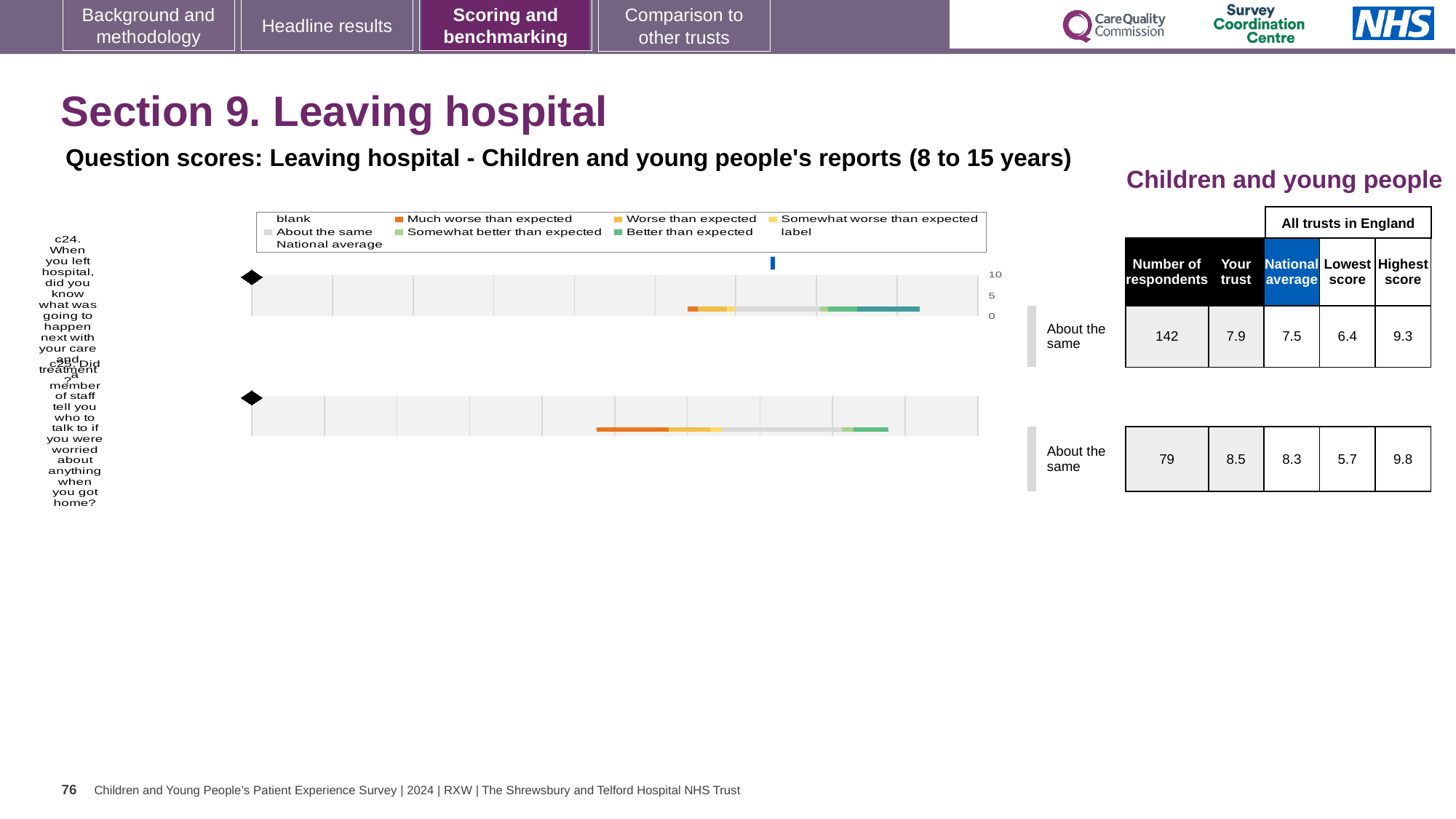
What is the highest score among all trusts in England for question c24? 9.3 By how much does the trust's score for c24 exceed the national average? 0.4 For question c25, is the trust's score higher or lower than the national average? Higher Which question had more respondents, c24 or c25? c24 What is the difference between the highest and lowest trust scores for question c25? 4.1 What is the national average score for question c25 (Did a member of staff tell you who to talk to if you were worried about anything when you got home?)? 8.3 What type of chart is used to show the benchmarking for each question? Bar chart How many survey questions are plotted on this slide? 2 What benchmark category is shown for question c24? About the same What is the lowest score among all trusts in England for question c25? 5.7 How many respondents answered question c24 (When you left hospital, did you know what was going to happen next with your care and treatment?)? 142 What is the 'Your trust' score for question c24? 7.9